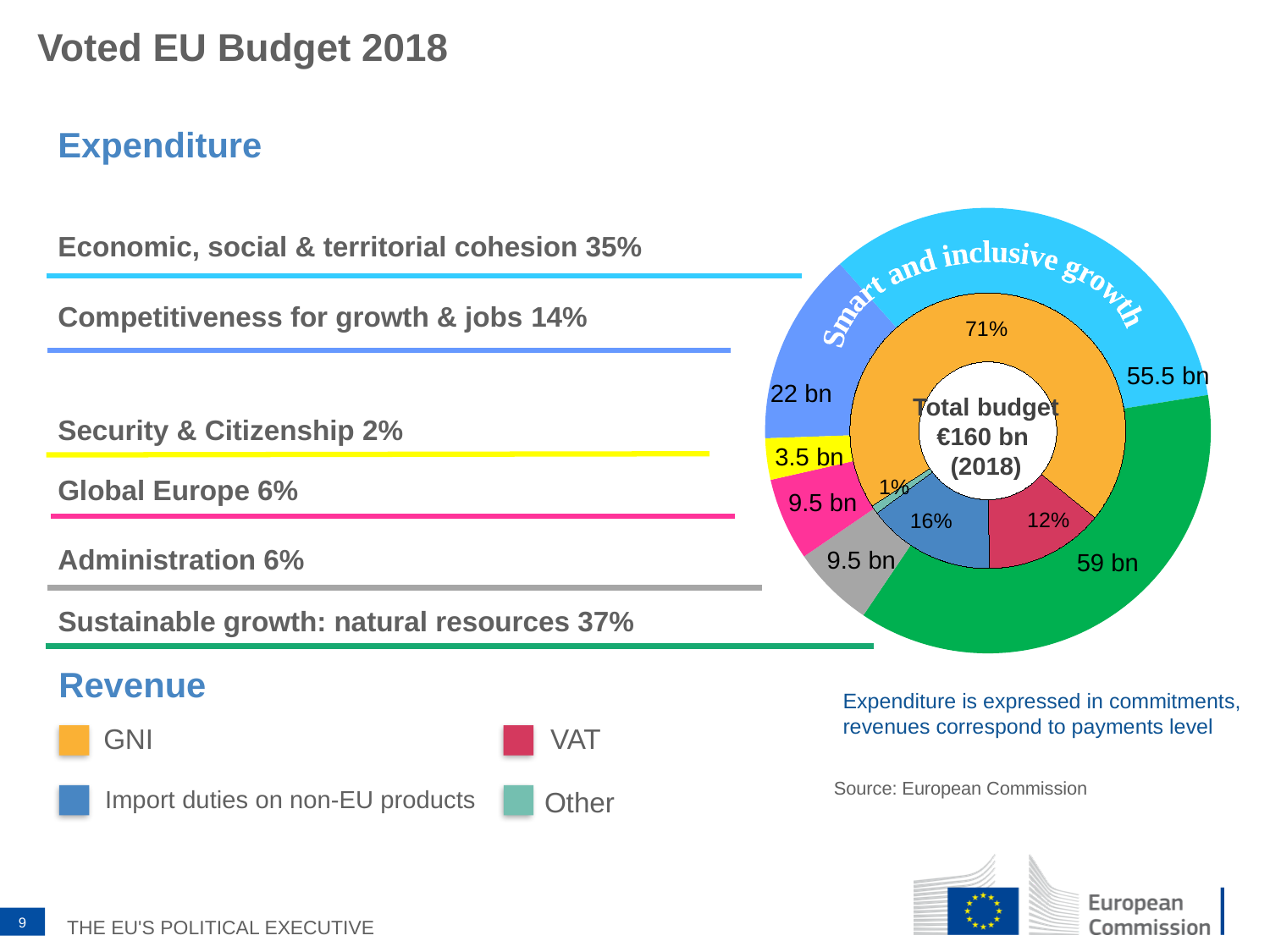
Which revenue source has the smallest share in the inner ring? Other Which revenue source has the largest share in the inner ring? GNI In the inner revenue ring, what share does VAT account for? 12% Which is larger in the outer expenditure ring: the 55.5 bn segment or the 22 bn segment? 55.5 bn segment In the inner revenue ring, what share does GNI account for? 71% In the outer expenditure ring, what amount is labelled on the green segment (Sustainable growth: natural resources)? 59 bn In the outer expenditure ring, what amount is labelled on the yellow segment (Security & Citizenship)? 3.5 bn What kind of chart is shown on the slide? Doughnut chart How many revenue sources are listed in the Revenue legend? 4 In the inner revenue ring, what share do import duties on non-EU products account for? 16% What is the difference in percentage points between the GNI share and the VAT share of revenue? 59 percentage points What is the total budget shown in the centre of the chart? €160 bn